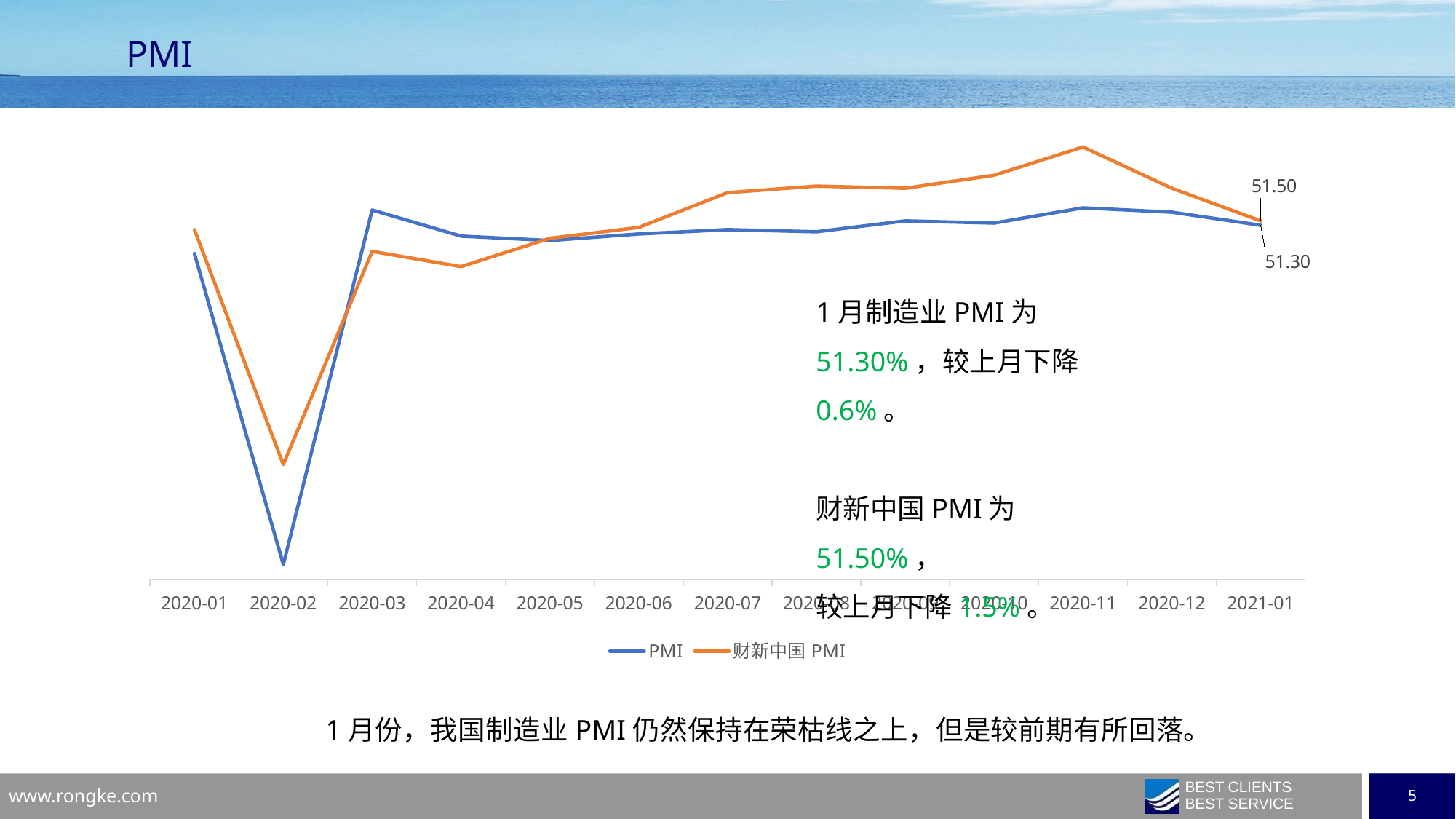
What is the value of the PMI series at 2021-01? 51.30 At 2020-02, which series is higher, PMI or 财新中国 PMI? 财新中国 PMI In which month does the PMI series reach its lowest point? 2020-02 What is the value of the 财新中国 PMI series at 2021-01? 51.50 In which month does the 财新中国 PMI series reach its lowest point? 2020-02 What kind of chart is shown on the slide? Line chart In which month does the 财新中国 PMI series reach its highest point? 2020-11 Does the 财新中国 PMI series rise or fall from 2020-04 to 2020-11? Rise How many series does the legend list? 2 Does the PMI series rise or fall from 2020-01 to 2020-02? Fall What is the difference between the 财新中国 PMI and PMI values at 2021-01? 0.20 At 2021-01, which series has the higher value, PMI or 财新中国 PMI? 财新中国 PMI